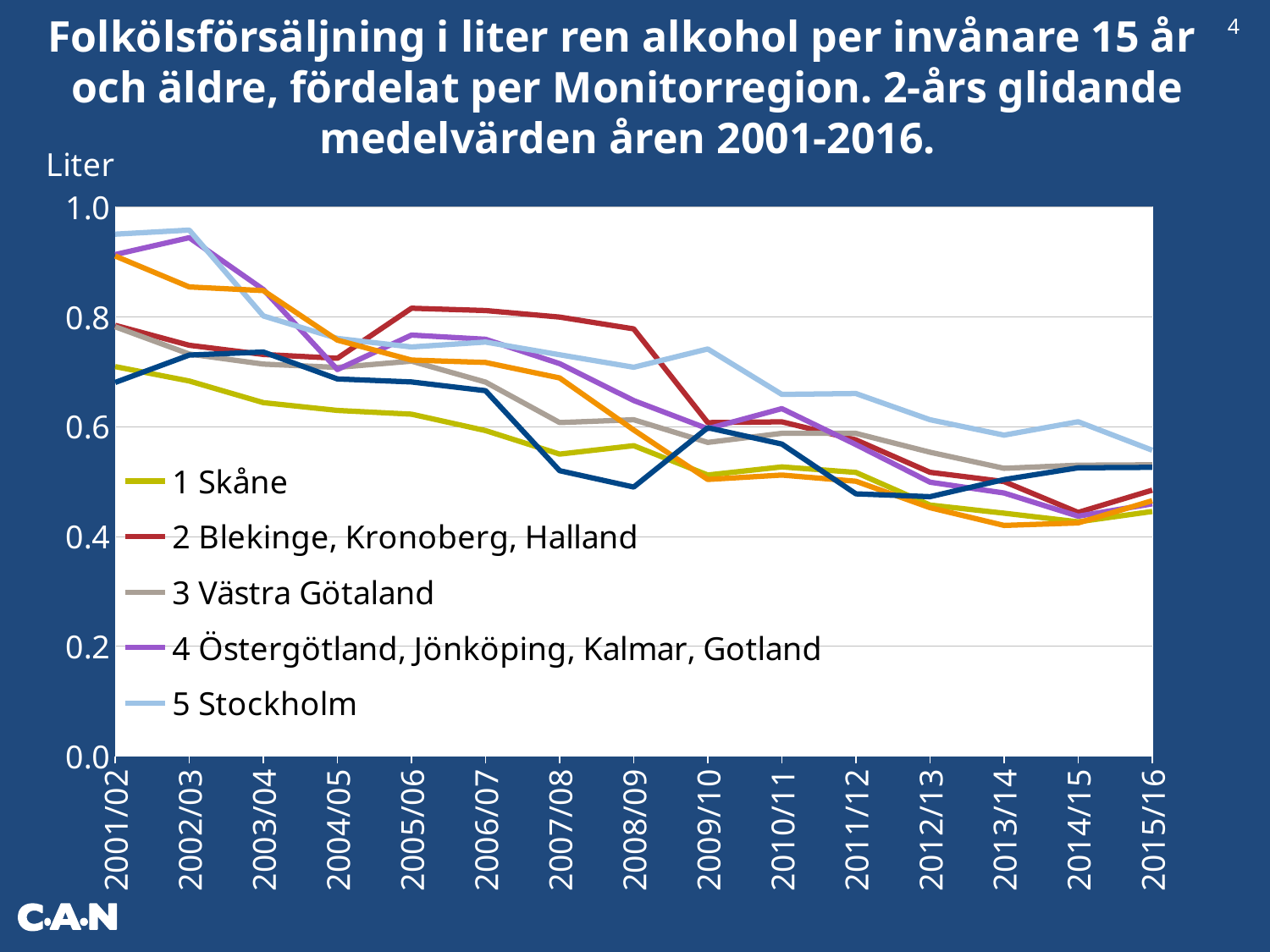
In 2008/09, which is larger: the value for 2 Blekinge, Kronoberg, Halland or the value for 1 Skåne? 2 Blekinge, Kronoberg, Halland Is the value for 3 Västra Götaland in 2015/16 greater or less than 0.6? less Does the value for 5 Stockholm generally rise or fall from 2001/02 to 2015/16? fall Is the value for 2 Blekinge, Kronoberg, Halland in 2005/06 greater or less than 0.8? greater Is the value for 4 Östergötland, Jönköping, Kalmar, Gotland in 2002/03 greater or less than 0.8? greater Which of the legend series has the highest value in 2001/02? 5 Stockholm What kind of chart is shown on the slide? line chart What is the label on the vertical axis? Liter How many series does the legend list? 5 How many time periods are shown on the x axis? 15